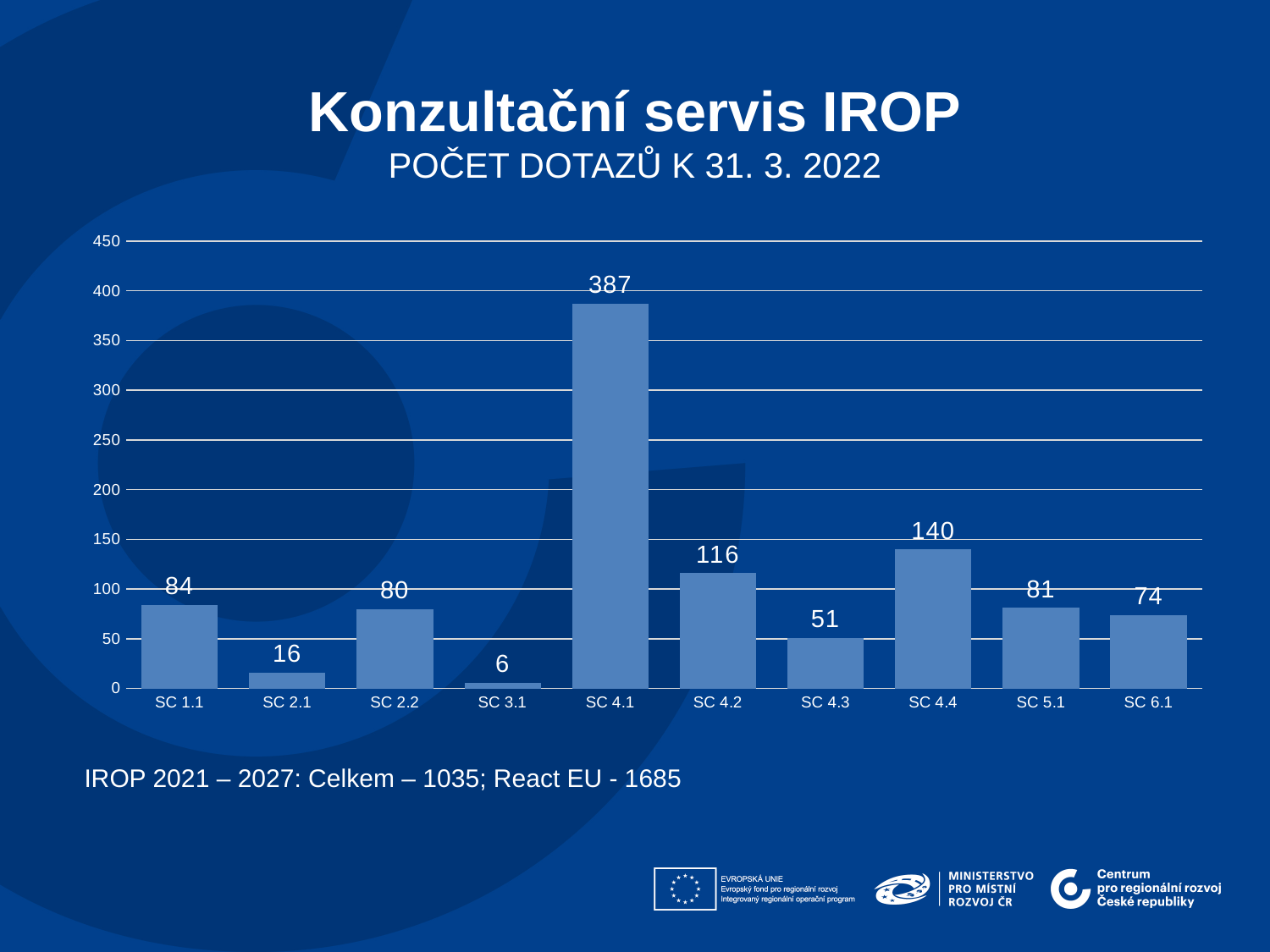
How many categories are shown on the x axis? 10 Which category has the lowest value? SC 3.1 Which category has the highest value? SC 4.1 What is the value for SC 2.1? 16 Is the value for SC 4.2 greater or less than 100? greater What is the value for SC 4.4? 140 What kind of chart is shown on the slide? bar chart What is the difference between the values for SC 1.1 and SC 2.2? 4 What is the difference between the values for SC 4.1 and SC 4.2? 271 What is the subtitle shown above the chart? POČET DOTAZŮ K 31. 3. 2022 What is the value for SC 4.1? 387 Which is larger, the value for SC 4.3 or the value for SC 6.1? SC 6.1